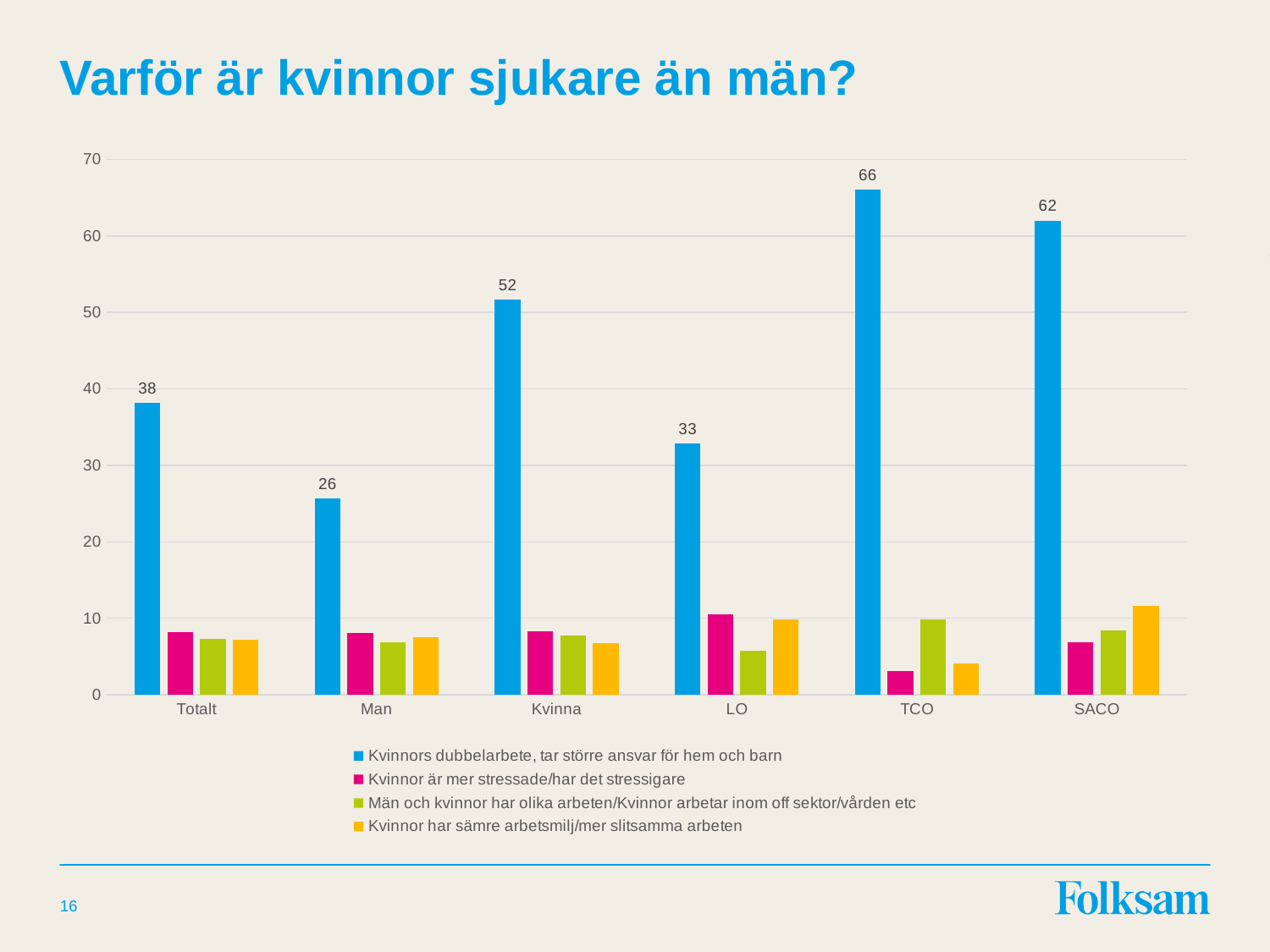
What is the value for Man in the series "Kvinnors dubbelarbete, tar större ansvar för hem och barn"? 26 How many series does the legend list? 4 What kind of chart is shown on the slide? bar chart What is the value for Kvinna in the series "Kvinnors dubbelarbete, tar större ansvar för hem och barn"? 52 What is the title of the slide? Varför är kvinnor sjukare än män? Is the value for LO in the series "Kvinnor är mer stressade/har det stressigare" greater or less than 20? less Which category has the lowest value in the series "Kvinnors dubbelarbete, tar större ansvar för hem och barn"? Man What is the value for TCO in the series "Kvinnors dubbelarbete, tar större ansvar för hem och barn"? 66 In the series "Kvinnors dubbelarbete, tar större ansvar för hem och barn", which is larger: the value for LO or the value for SACO? SACO How many categories are shown on the x axis? 6 What is the difference between the Kvinna and Man values in the series "Kvinnors dubbelarbete, tar större ansvar för hem och barn"? 26 Which category has the highest value in the series "Kvinnors dubbelarbete, tar större ansvar för hem och barn"? TCO